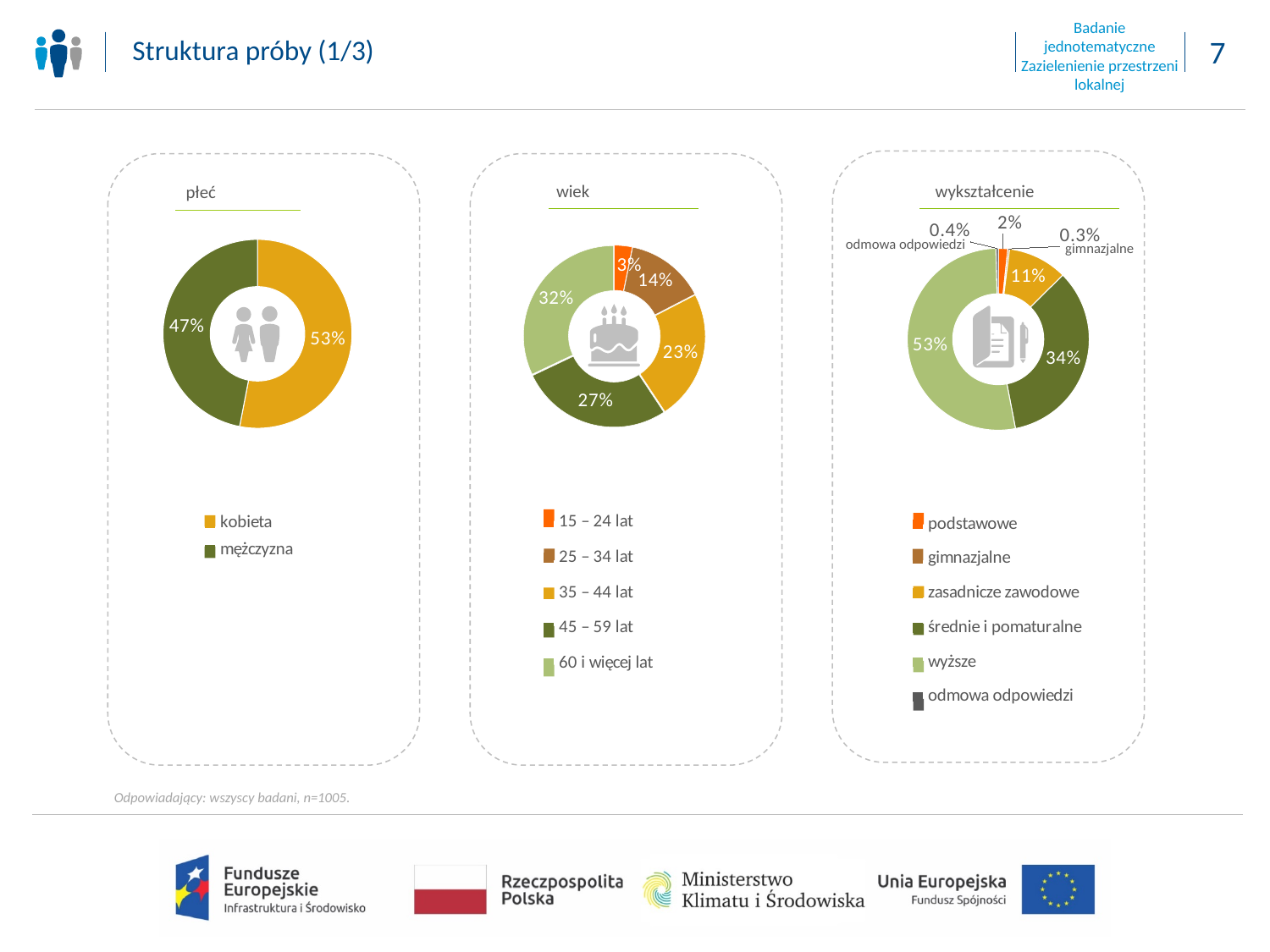
In the 'wykształcenie' chart, which category has the largest share? wyższe In the 'wiek' chart, which age group has the smallest share? 15 – 24 lat In the 'płeć' chart, what is the difference between the kobieta and mężczyzna shares? 6% In the 'wiek' chart, how many age groups does the legend list? 5 In the 'płeć' chart, what share is labelled for mężczyzna? 47% In the 'wykształcenie' chart, what share is labelled for średnie i pomaturalne? 34% In the 'wykształcenie' chart, which is larger: zasadnicze zawodowe or podstawowe? zasadnicze zawodowe In the 'płeć' chart, what share is labelled for kobieta? 53% In the 'wiek' chart, which age group has the largest share? 60 i więcej lat In the 'wykształcenie' chart, what share is labelled for odmowa odpowiedzi? 0.4% What kind of chart is used for the 'wiek' data? Donut (pie) chart In the 'wiek' chart, what share is labelled for the 35 – 44 lat group? 23%